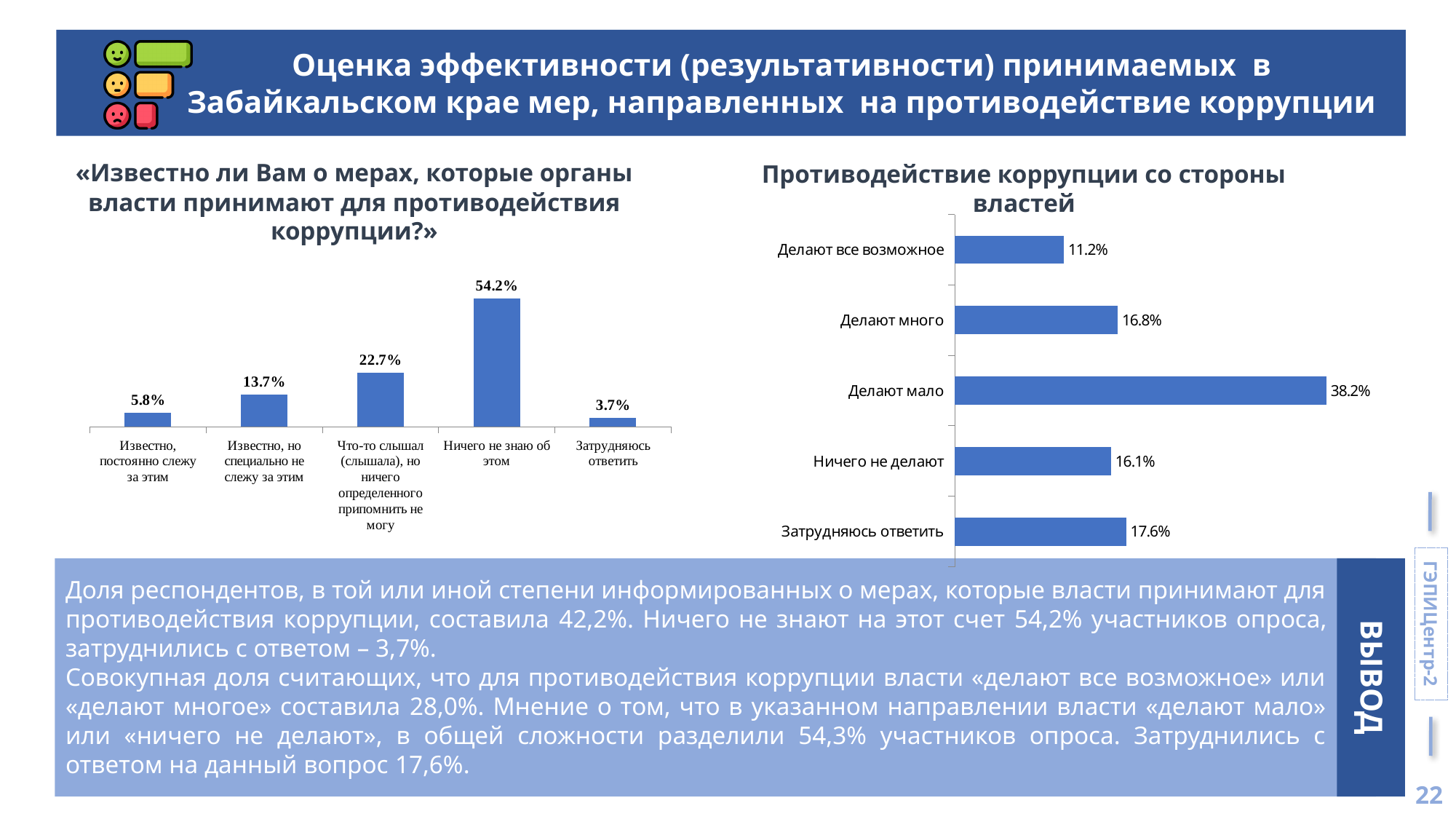
In the right chart («Противодействие коррупции со стороны властей»), which category has the highest value? Делают мало In the left chart («Известно ли Вам о мерах...»), how many categories are shown? 5 What type of chart is the left chart («Известно ли Вам о мерах...»)? Bar chart In the right chart («Противодействие коррупции со стороны властей»), what is the value for «Делают мало»? 38.2% In the left chart («Известно ли Вам о мерах...»), what is the value for «Ничего не знаю об этом»? 54.2% In the left chart («Известно ли Вам о мерах...»), which category has the lowest value? Затрудняюсь ответить In the right chart («Противодействие коррупции со стороны властей»), what is the difference between «Делают мало» and «Делают все возможное»? 27.0% In the right chart («Противодействие коррупции со стороны властей»), which category has the lowest value? Делают все возможное In the left chart («Известно ли Вам о мерах...»), what is the difference between «Что-то слышал (слышала)...» and «Известно, но специально не слежу за этим»? 9.0% In the right chart («Противодействие коррупции со стороны властей»), which is larger: «Делают много» or «Ничего не делают»? Делают много In the left chart («Известно ли Вам о мерах...»), what is the value for «Известно, постоянно слежу за этим»? 5.8% In the right chart («Противодействие коррупции со стороны властей»), what is the value for «Затрудняюсь ответить»? 17.6%